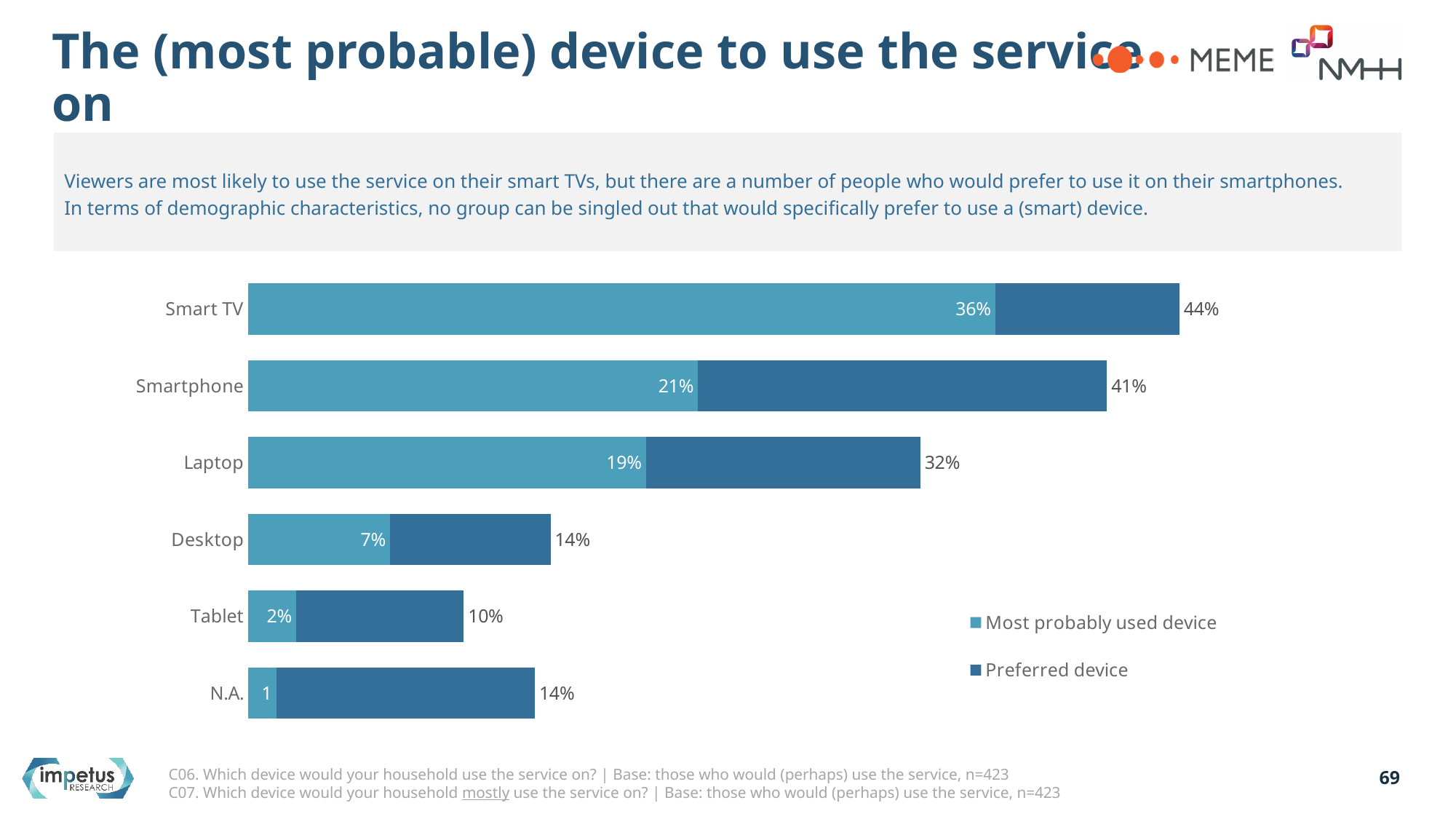
Which device has the lowest 'Preferred device' value? Tablet How many device categories are shown in the chart? 6 What is the 'Most probably used device' value for Smartphone? 21% What is the 'Preferred device' value for Laptop? 32% What are the two legend entries of the chart? Most probably used device; Preferred device What is the 'Most probably used device' value for Tablet? 2% How many series does the legend list? 2 What kind of chart is shown on the slide? Bar chart What is the difference between the 'Preferred device' and 'Most probably used device' values for Smartphone? 20% Which device has the highest 'Most probably used device' value? Smart TV Which is larger: the 'Preferred device' value for Laptop or for Desktop? Laptop What is the 'Preferred device' value for Smart TV? 44%